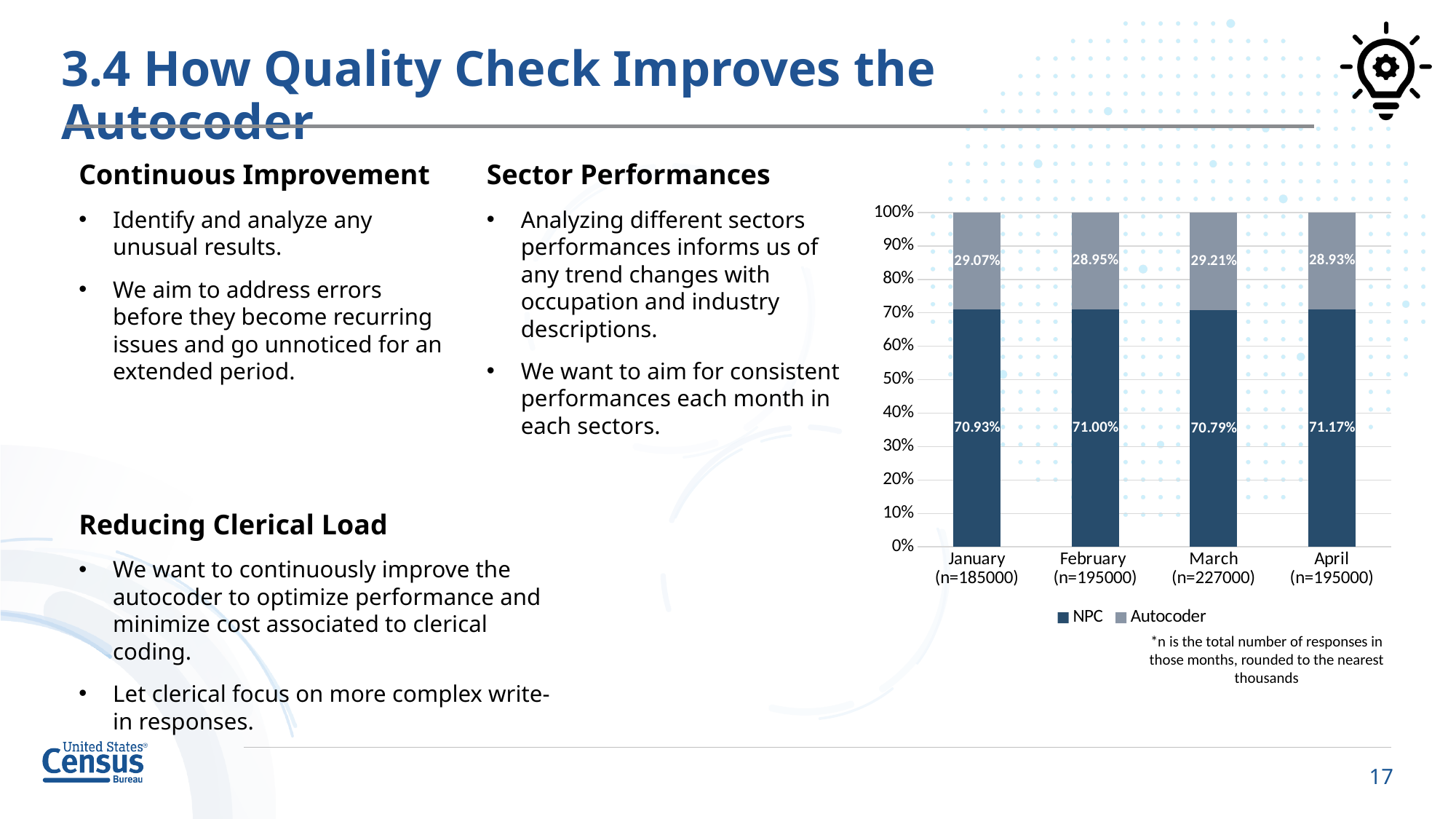
Which month has the highest Autocoder value? March What is the total of the stacked bar for January? 100% What is the difference between the NPC values for April and March? 0.38% What is the NPC value for January? 70.93% What is the Autocoder value for March? 29.21% What is the NPC value for April? 71.17% Which month has the highest NPC value? April How many months are shown on the x axis? 4 Which month has the lowest NPC value? March What kind of chart is shown on the slide? Stacked bar chart How many series does the legend list? 2 Which is larger, the NPC value for February or for January? February